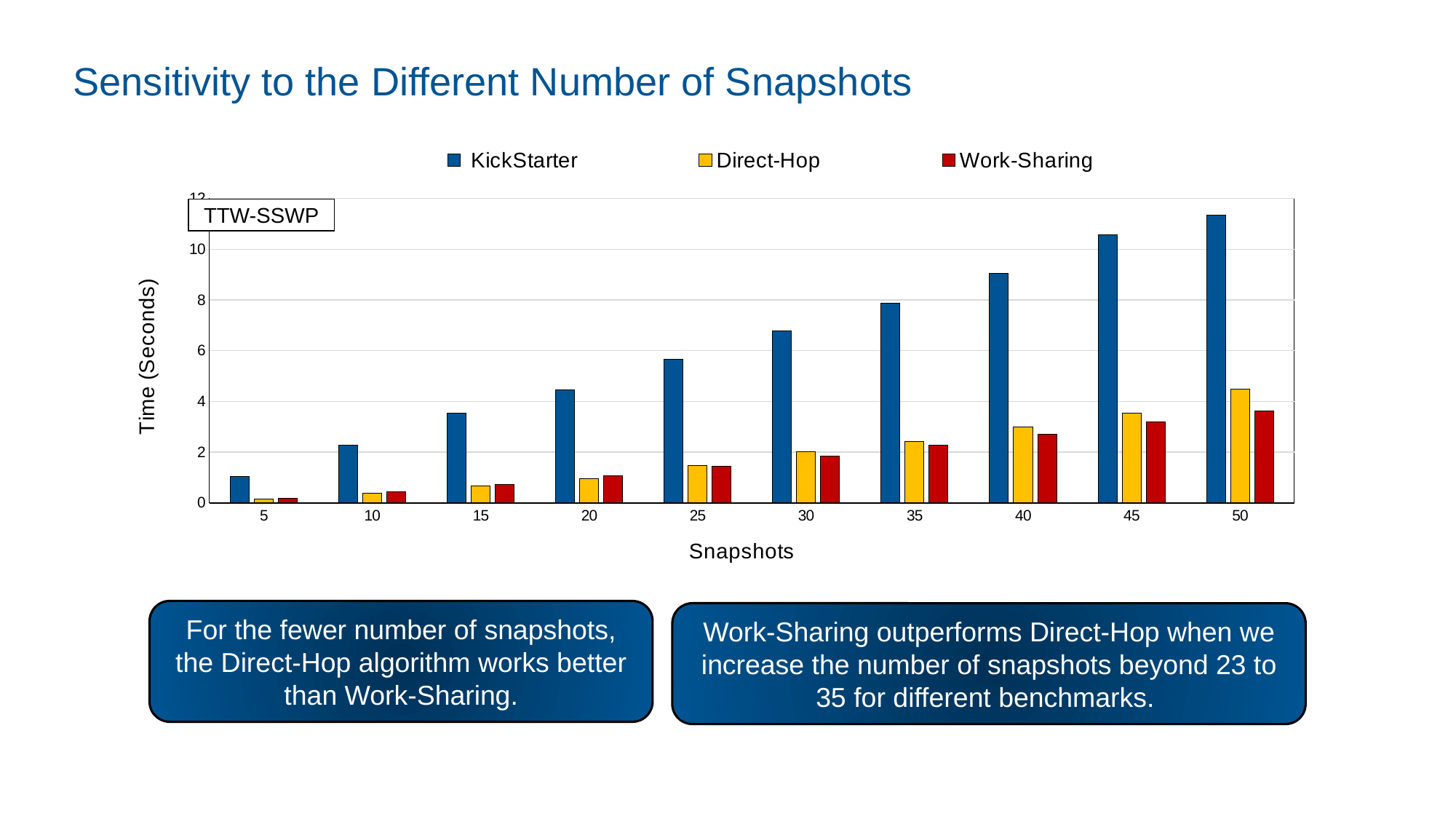
At which number of snapshots is the KickStarter time highest? 50 What is the label on the y axis of the chart? Time (Seconds) What kind of chart is shown on the slide? bar chart Is the KickStarter value at 50 snapshots greater or less than 10? greater How many snapshot categories are shown on the x axis? 10 Is the Work-Sharing value at 45 snapshots greater or less than 4? less How many series does the legend list? 3 Is the Direct-Hop value at 50 snapshots greater or less than 4? greater Do the KickStarter values rise or fall as the number of snapshots increases? rise At 50 snapshots, which is larger: Direct-Hop or Work-Sharing? Direct-Hop At which number of snapshots is the KickStarter time lowest? 5